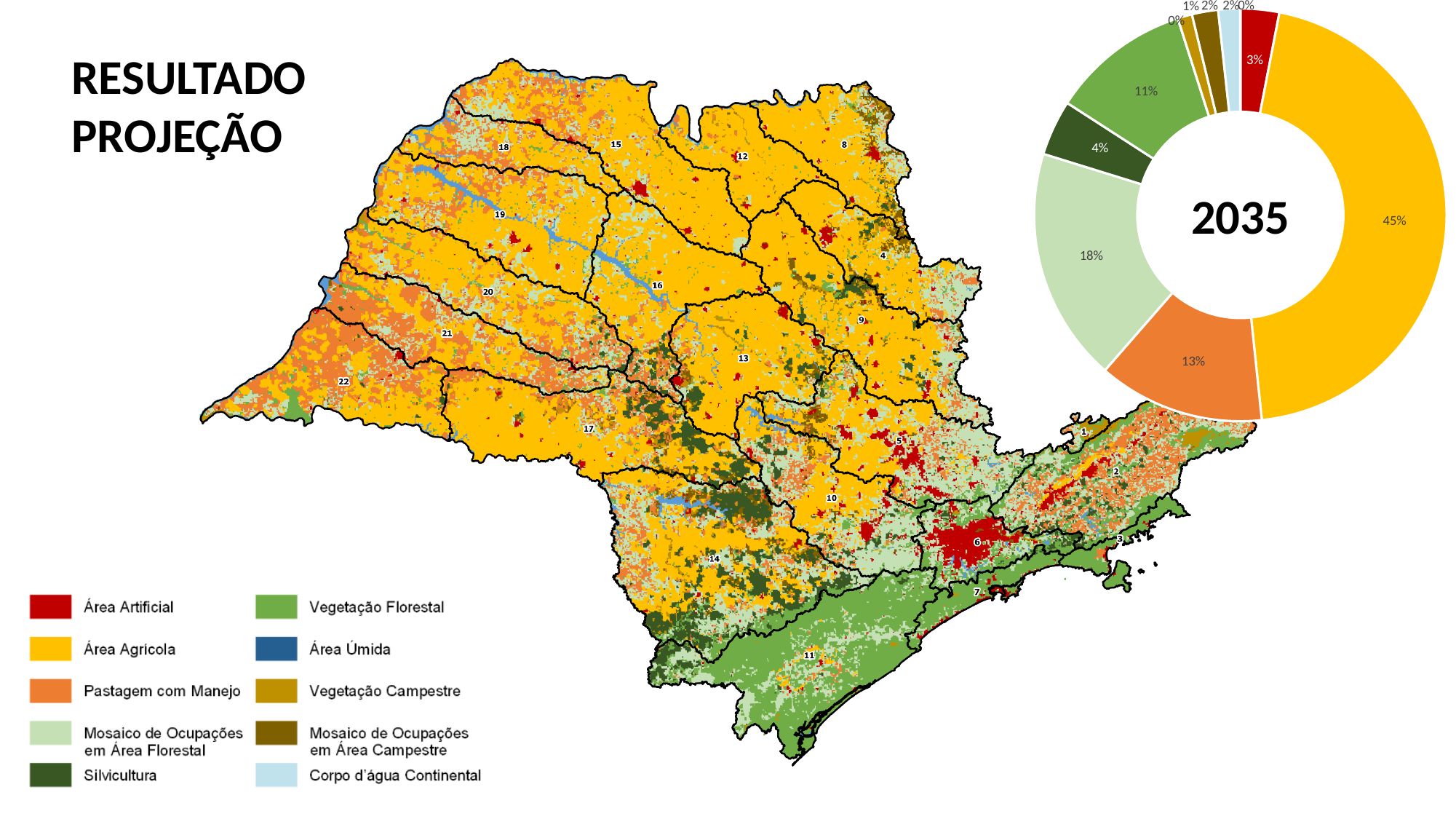
In the doughnut chart, how many percentage points larger is the yellow slice (45%) than the orange slice (13%)? 32 percentage points In the doughnut chart, which is larger: the light green slice (Mosaico de Ocupações em Área Florestal) or the orange slice (Pastagem com Manejo)? The light green slice (18% vs 13%) In the doughnut chart, what percentage is shown for the light green slice (Mosaico de Ocupações em Área Florestal)? 18% In the doughnut chart, what percentage is shown for the medium green slice (Vegetação Florestal)? 11% In the doughnut chart, what percentage is shown for the orange slice (Pastagem com Manejo)? 13% In the doughnut chart, what percentage is shown for the dark green slice (Silvicultura)? 4% In the doughnut chart, what percentage is shown for the largest (yellow, Área Agrícola) slice? 45% Which land-use category has the largest share in the doughnut chart? Área Agrícola (yellow, 45%) In the doughnut chart, what percentage is shown for the red slice (Área Artificial)? 3% In the doughnut chart, what is the difference between the Vegetação Florestal slice (11%) and the Silvicultura slice (4%)? 7 percentage points What kind of chart is shown on the right side of the slide? A doughnut (pie) chart What year is written in the centre of the doughnut chart? 2035